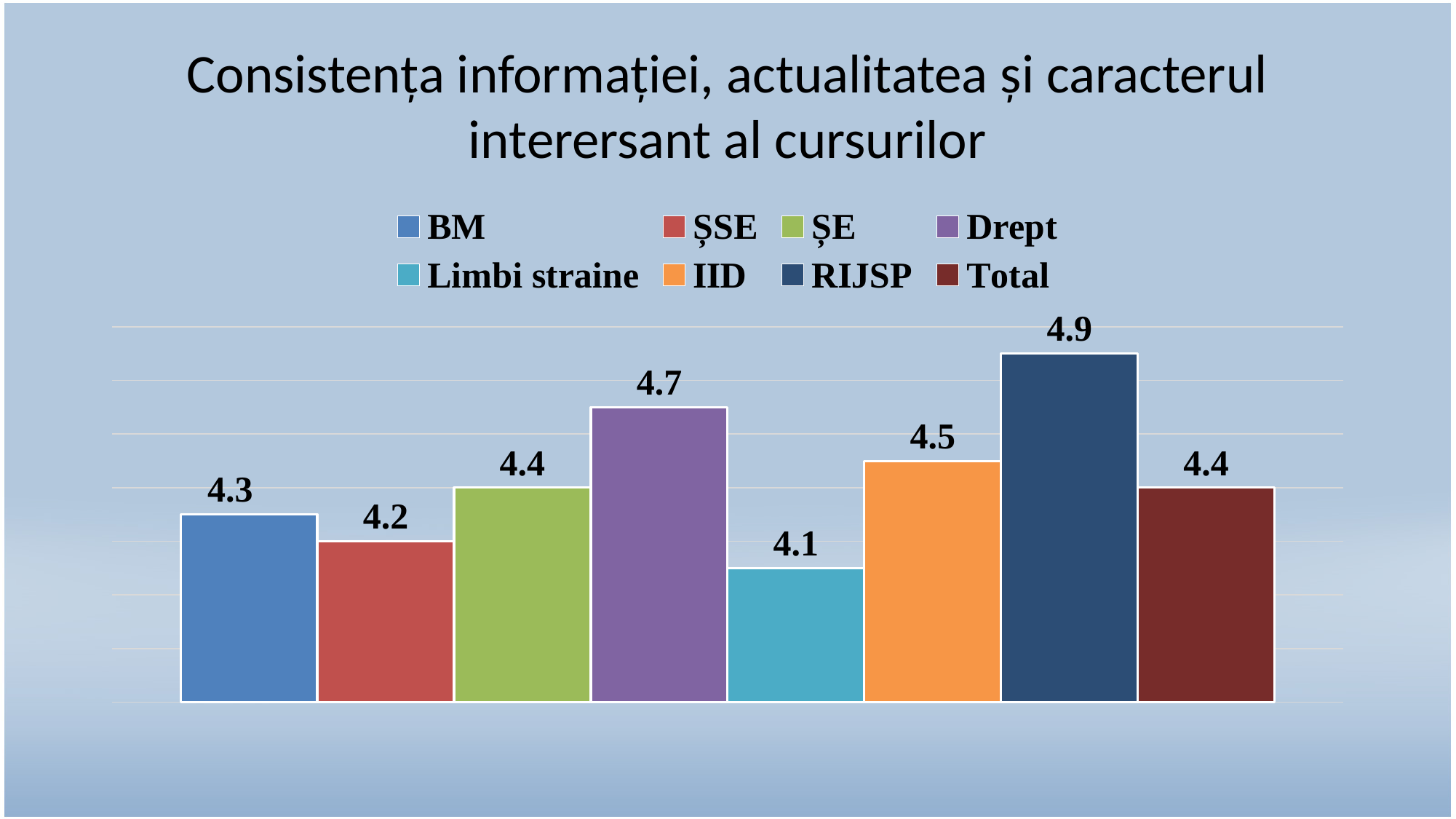
Which is larger, the value for IID or the value for ȘSE? IID Which series has the highest value? RIJSP What is the value for Total? 4.4 How many series does the legend list? 8 What is the difference between the values for RIJSP and Limbi straine? 0.8 What is the difference between the values for Drept and BM? 0.4 What is the value for Drept? 4.7 Which series has the lowest value? Limbi straine What is the value for Limbi straine? 4.1 What kind of chart is shown on the slide? Bar chart What is the title of the slide? Consistența informației, actualitatea și caracterul interersant al cursurilor What is the value for RIJSP? 4.9